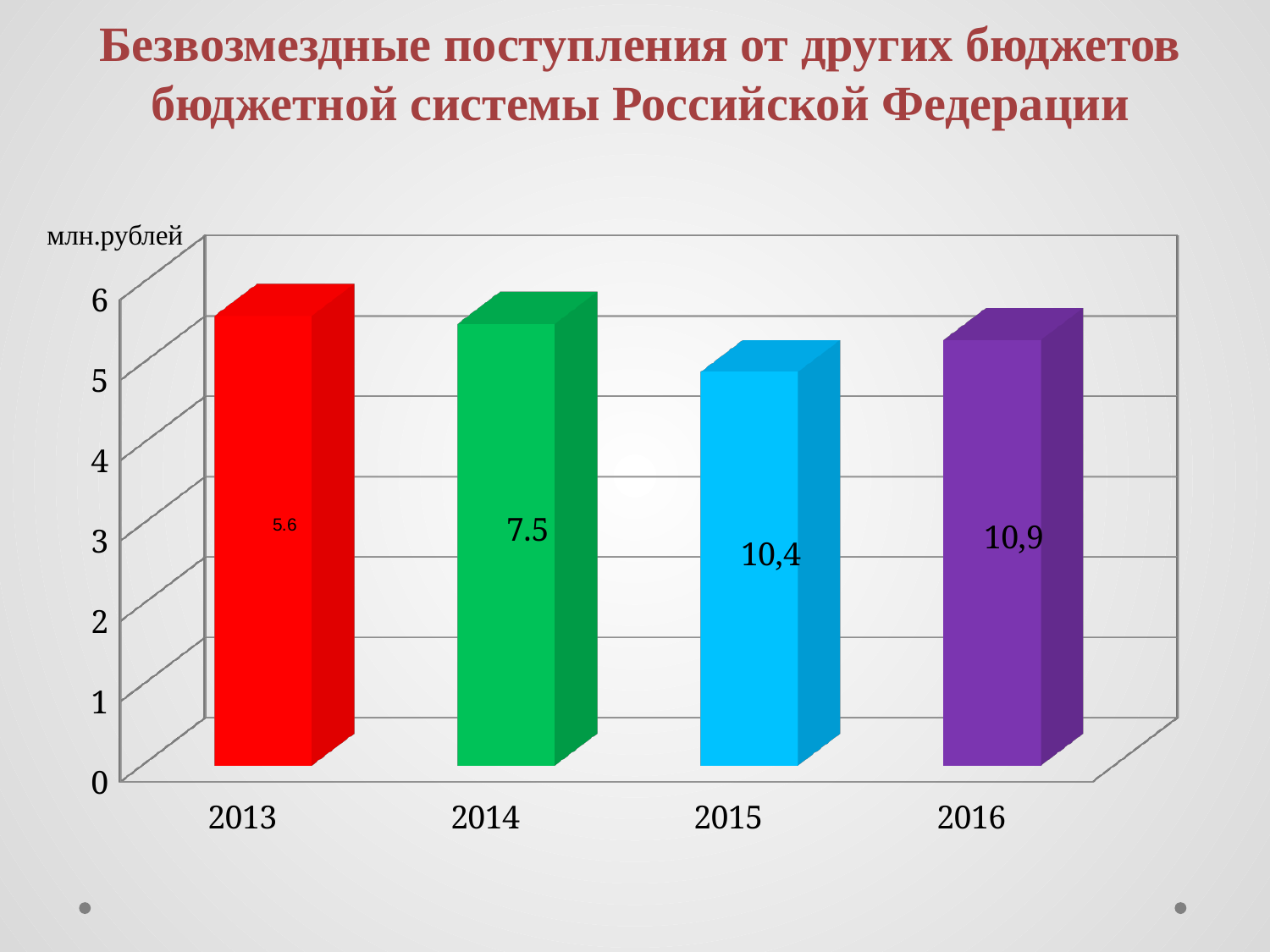
What is the value shown for 2013? 5.6 According to the data labels, which is larger, the value for 2014 or the value for 2013? 2014 What is the value shown for 2015? 10,4 What is the value shown for 2016? 10,9 What unit is indicated above the vertical axis? млн.рублей What colour is the bar for 2015? blue How many years are shown on the x axis? 4 What is the value shown for 2014? 7.5 What kind of chart is shown on the slide? bar chart According to the data labels, what is the difference between the values for 2016 and 2015? 0,5 According to the data labels, what is the difference between the values for 2014 and 2013? 1.9